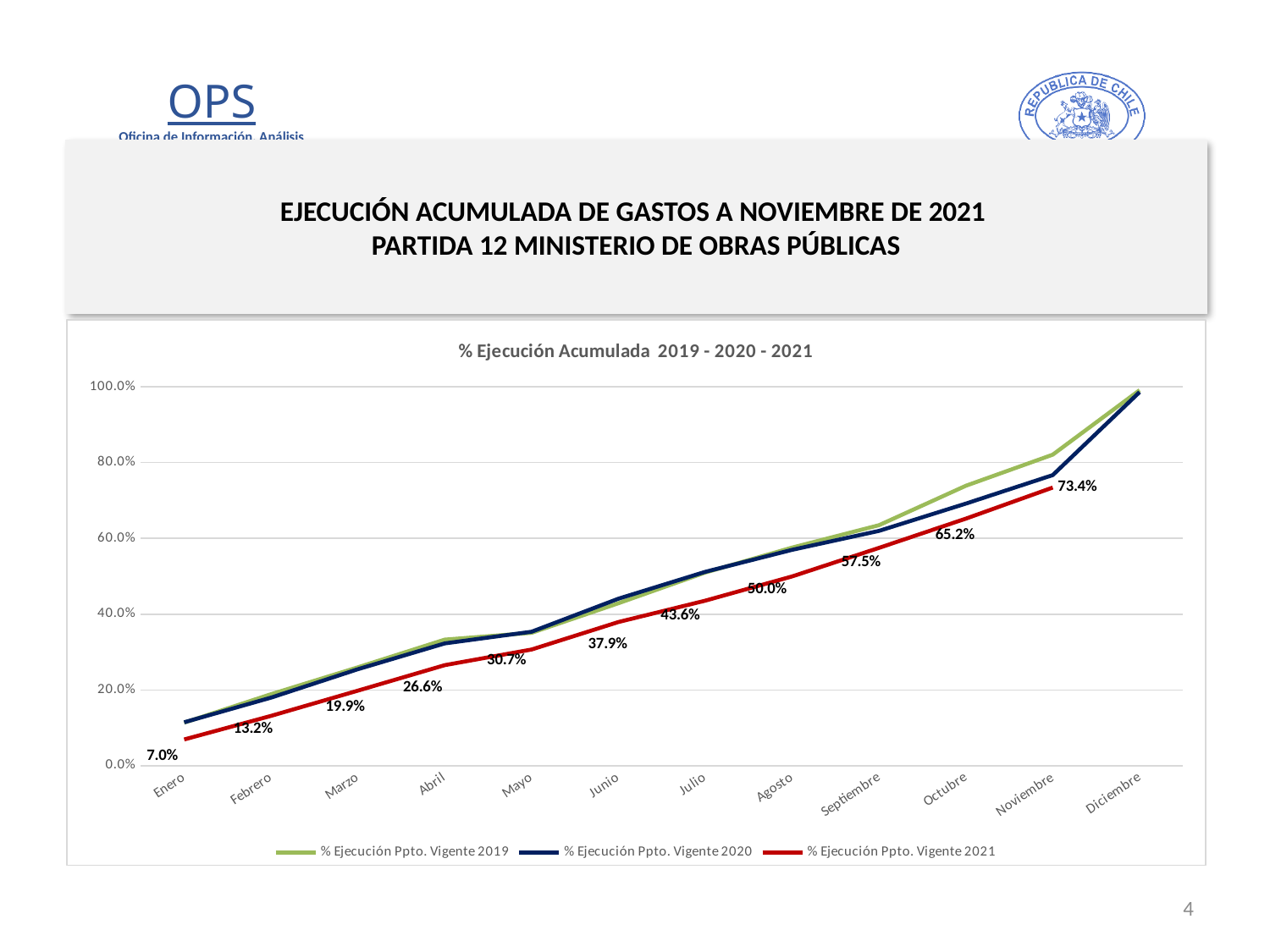
What kind of chart is shown on the slide? Line chart What is the value of % Ejecución Ppto. Vigente 2021 for Junio? 37.9% What is the value of % Ejecución Ppto. Vigente 2021 for Enero? 7.0% How many series does the legend list? 3 Which month has the lowest labelled value for % Ejecución Ppto. Vigente 2021? Enero Is the value for % Ejecución Ppto. Vigente 2019 in Diciembre greater or less than 80.0%? greater What is the difference between the % Ejecución Ppto. Vigente 2021 values for Febrero and Enero? 6.2% Which month has the highest labelled value for % Ejecución Ppto. Vigente 2021? Noviembre What is the value of % Ejecución Ppto. Vigente 2021 for Noviembre? 73.4% What is the value of % Ejecución Ppto. Vigente 2021 for Agosto? 50.0% What is the difference between the % Ejecución Ppto. Vigente 2021 values for Noviembre and Octubre? 8.2% How many months are shown on the x axis? 12